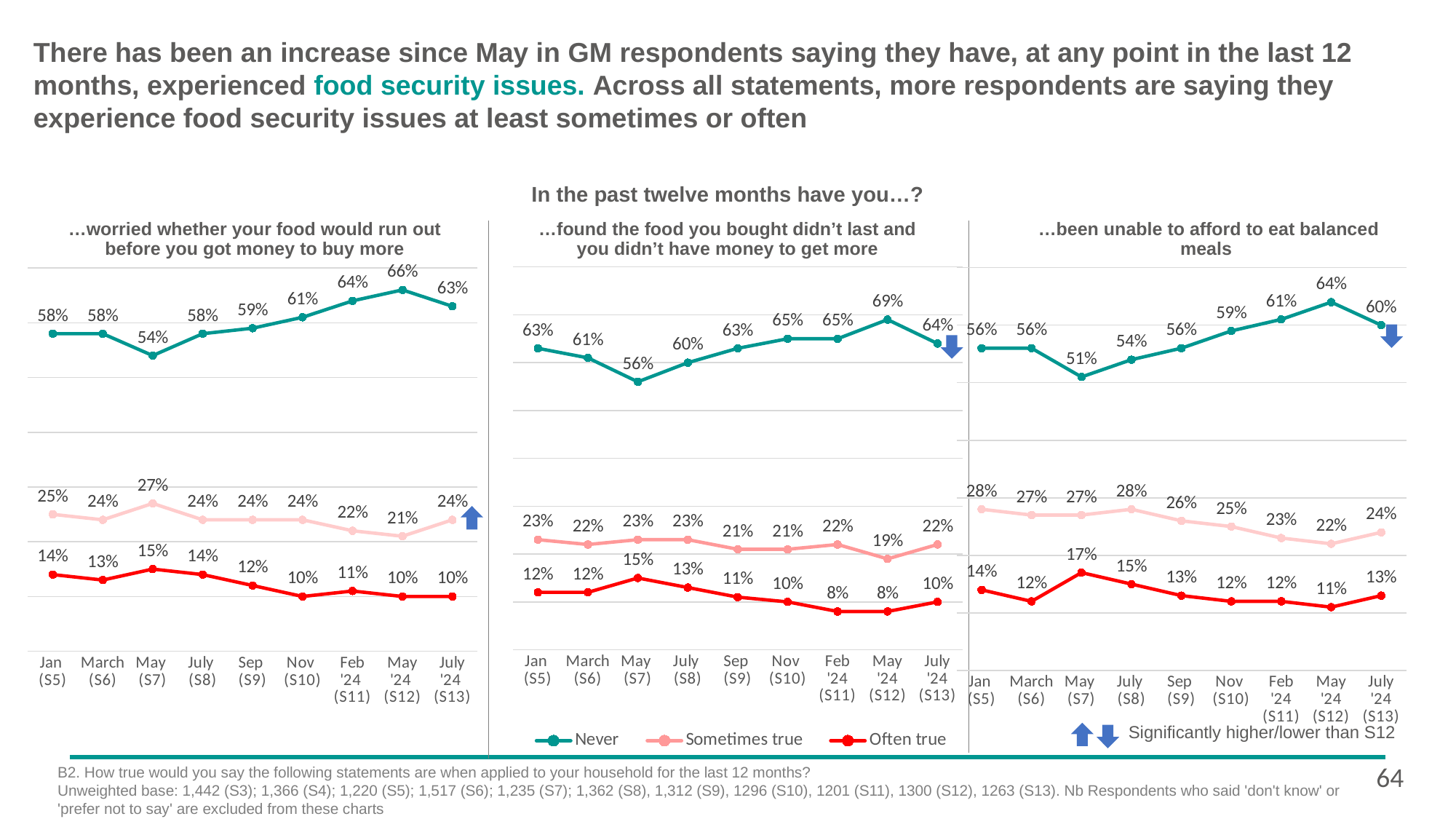
How many time points are plotted on the x axis of each chart? 9 In the chart '…found the food you bought didn't last and you didn't have money to get more', at which time point is the Never series lowest? May (S7) In the chart '…been unable to afford to eat balanced meals', does the Sometimes true series generally rise or fall from Jan (S5) to May '24 (S12)? Fall In the chart '…found the food you bought didn't last and you didn't have money to get more', which is larger: Sometimes true in Jan (S5) or Sometimes true in May '24 (S12)? Jan (S5) In the chart '…been unable to afford to eat balanced meals', what is the difference between Never in May '24 (S12) and July '24 (S13)? 4 percentage points How many series does the legend list? 3 In the chart '…worried whether your food would run out before you got money to buy more', at which time point is the Never series highest? May '24 (S12) What type of chart is used for '…worried whether your food would run out before you got money to buy more'? Line chart In the chart '…worried whether your food would run out before you got money to buy more', what is the value for Never in July '24 (S13)? 63% In the chart '…been unable to afford to eat balanced meals', what is the value for Often true in May (S7)? 17% In the chart '…found the food you bought didn't last and you didn't have money to get more', what is the value for Often true in Feb '24 (S11)? 8% In the chart '…worried whether your food would run out before you got money to buy more', what is the difference between Sometimes true in July '24 (S13) and May '24 (S12)? 3 percentage points